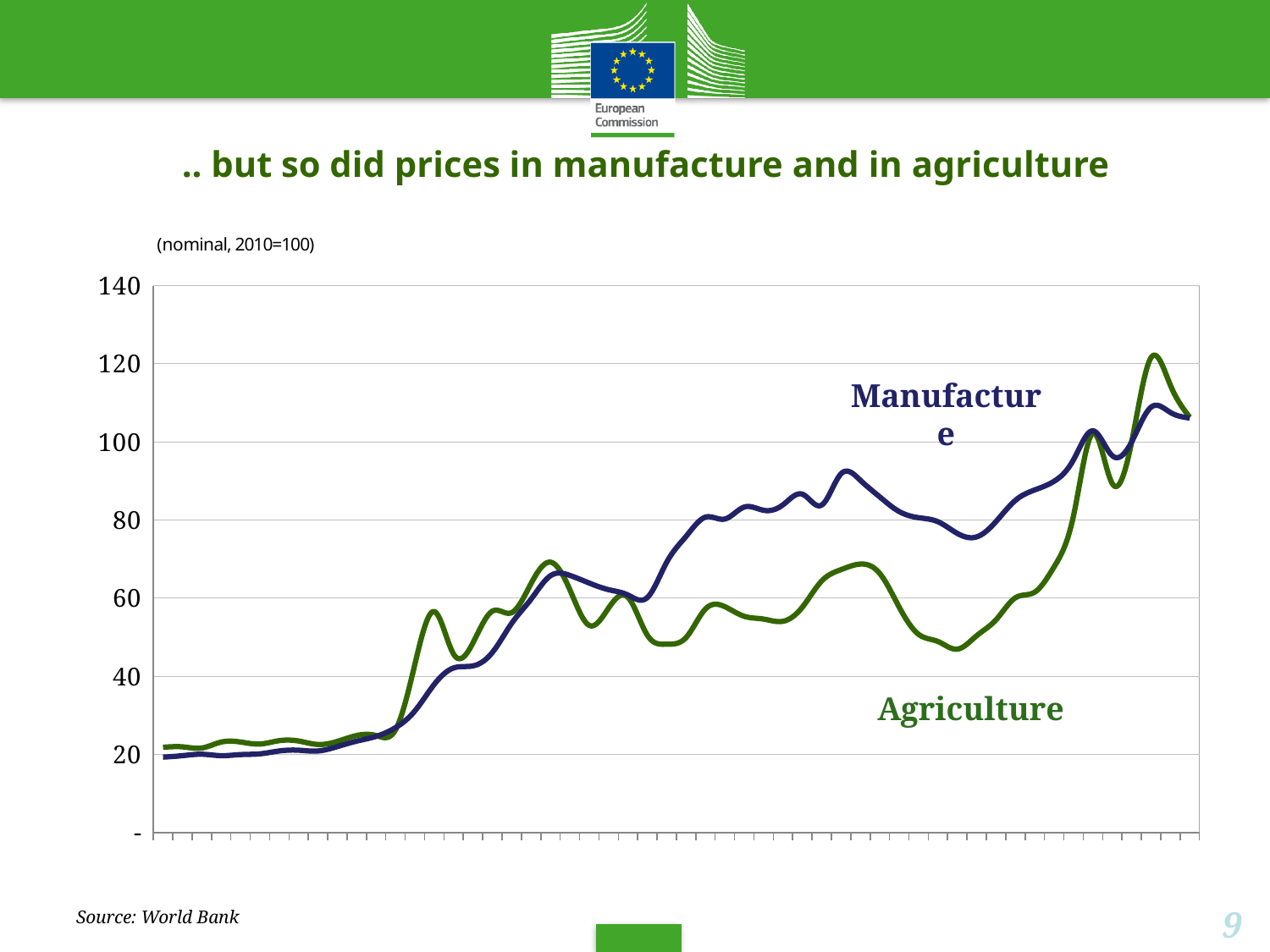
Is the lowest value of the Agriculture line in the right half of the chart greater or less than 60? less What kind of chart is shown on the slide? line chart What is the title of the slide above the chart? .. but so did prices in manufacture and in agriculture What are the names of the two series plotted on the chart? Manufacture and Agriculture Is the value of the Manufacture line at the start of the series greater or less than 40? less Is the value of the Agriculture line at the start of the series greater or less than 40? less Overall, do the Agriculture values rise or fall from left to right along the x axis? rise Overall, do the Manufacture values rise or fall from left to right along the x axis? rise How many series are plotted on the chart? 2 Which series reaches the higher peak value on the chart, Manufacture or Agriculture? Agriculture